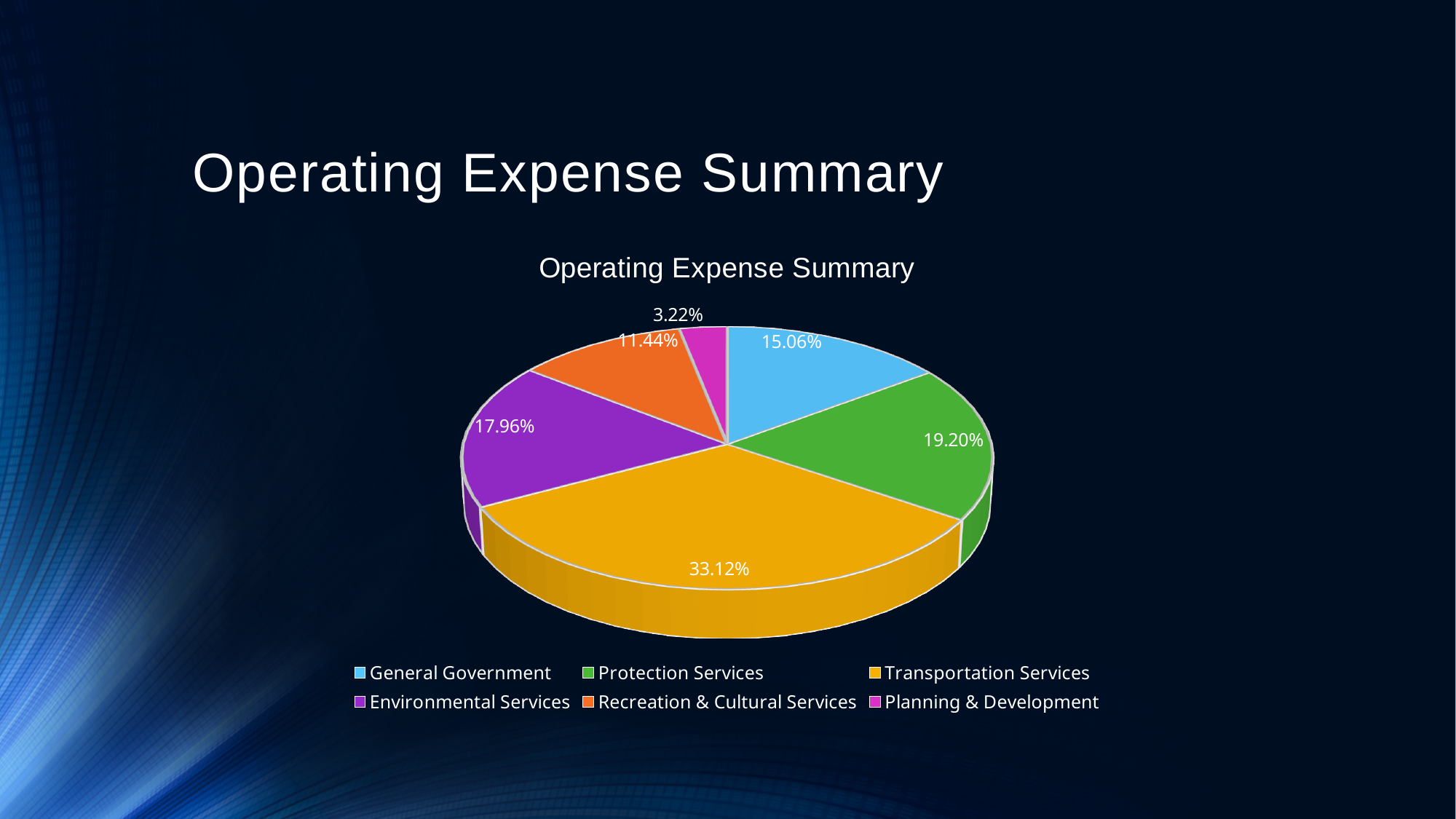
Which category has the largest slice of the pie? Transportation Services What is the value shown for General Government? 15.06% How many categories are shown in the pie chart? 6 What is the value shown for Protection Services? 19.20% What is the value shown for Planning & Development? 3.22% What share of the pie does Transportation Services account for? 33.12% Which category has the smallest slice of the pie? Planning & Development What is the difference between the Transportation Services share and the Protection Services share? 13.92% What colour is the Recreation & Cultural Services slice? Orange What is the value shown for Environmental Services? 17.96% Which is larger, the share for Protection Services or the share for Environmental Services? Protection Services What kind of chart is shown on the slide? Pie chart